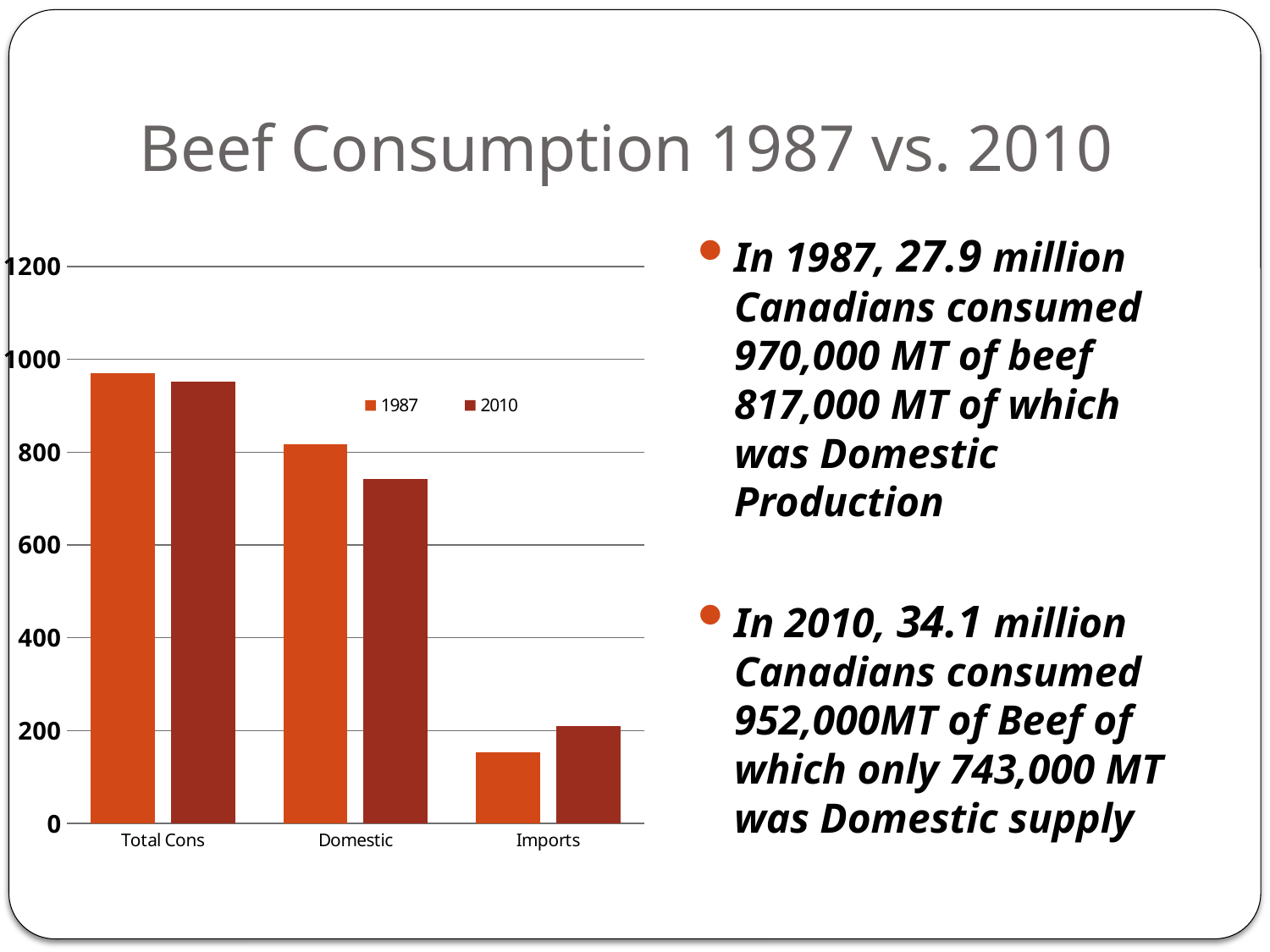
For the Domestic category, which series has the larger value, 1987 or 2010? 1987 Which category has the highest value for the 1987 series? Total Cons What are the two series names listed in the chart legend? 1987 and 2010 What kind of chart is shown on the slide? bar chart Is the value for Domestic in 2010 greater or less than 800? less Is the value for Total Cons in 1987 greater or less than 1000? less Is the value for Imports in 1987 greater or less than 200? less Which category has the lowest value for the 2010 series? Imports For the Imports category, which series has the larger value, 1987 or 2010? 2010 How many categories are shown on the x axis of the chart? 3 What is the title of the slide containing the chart? Beef Consumption 1987 vs. 2010 How many series does the chart legend list? 2